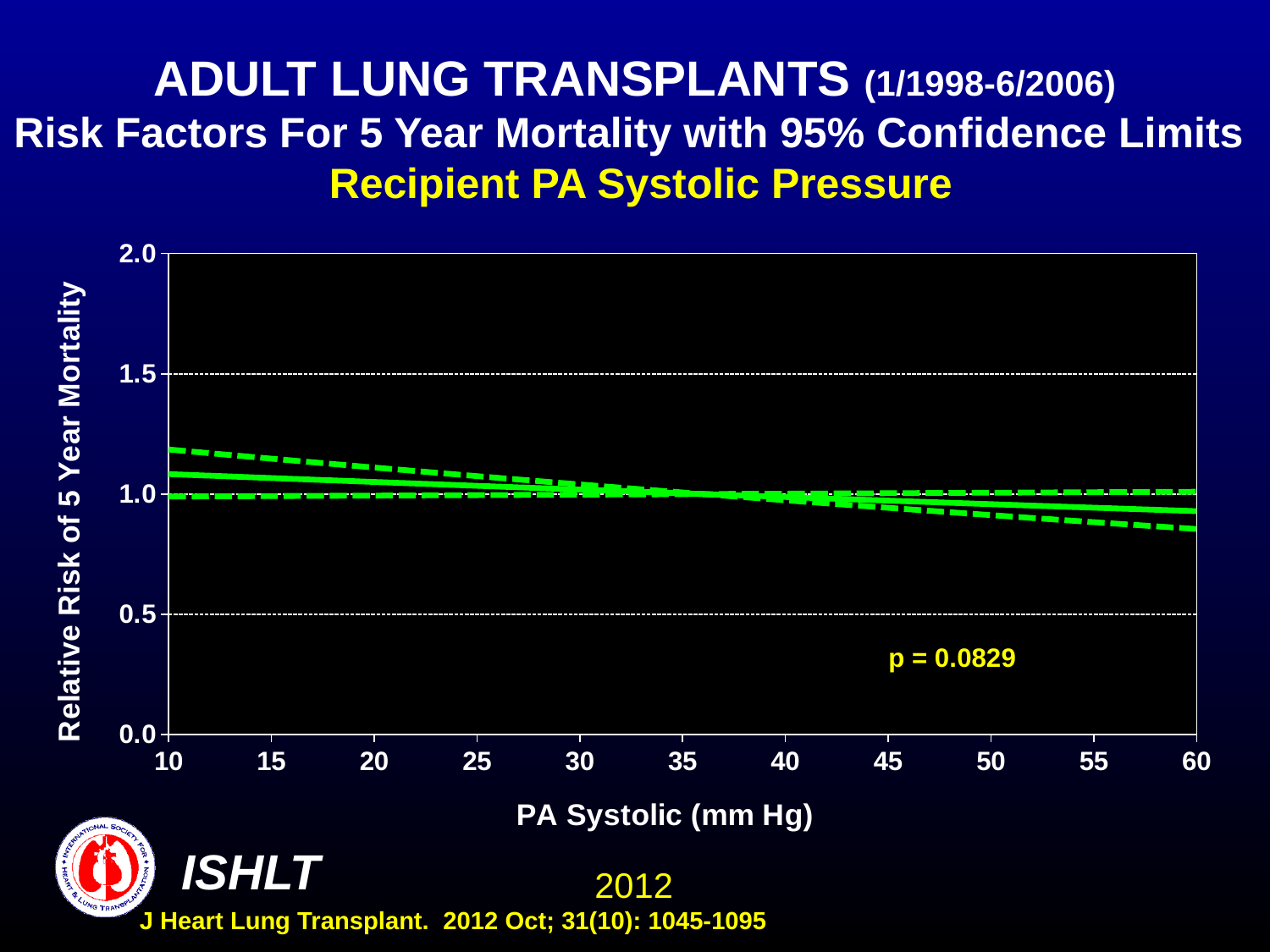
Is the relative risk of 5 year mortality at a PA systolic pressure of 60 mm Hg greater or less than 1.0? less What kind of chart is shown on the slide? line chart What is the label of the y axis? Relative Risk of 5 Year Mortality What is the label of the x axis? PA Systolic (mm Hg) Is the relative risk of 5 year mortality at a PA systolic pressure of 10 mm Hg greater or less than 1.0? greater Is the relative risk of 5 year mortality at a PA systolic pressure of 10 mm Hg greater or less than 1.5? less Does the relative risk of 5 year mortality rise or fall as PA systolic pressure increases from 10 to 60 mm Hg? fall What is the highest value shown on the y axis? 2.0 What p-value is printed on the chart? p = 0.0829 What is the lowest PA systolic pressure shown on the x axis? 10 How many tick marks are labelled on the x axis? 11